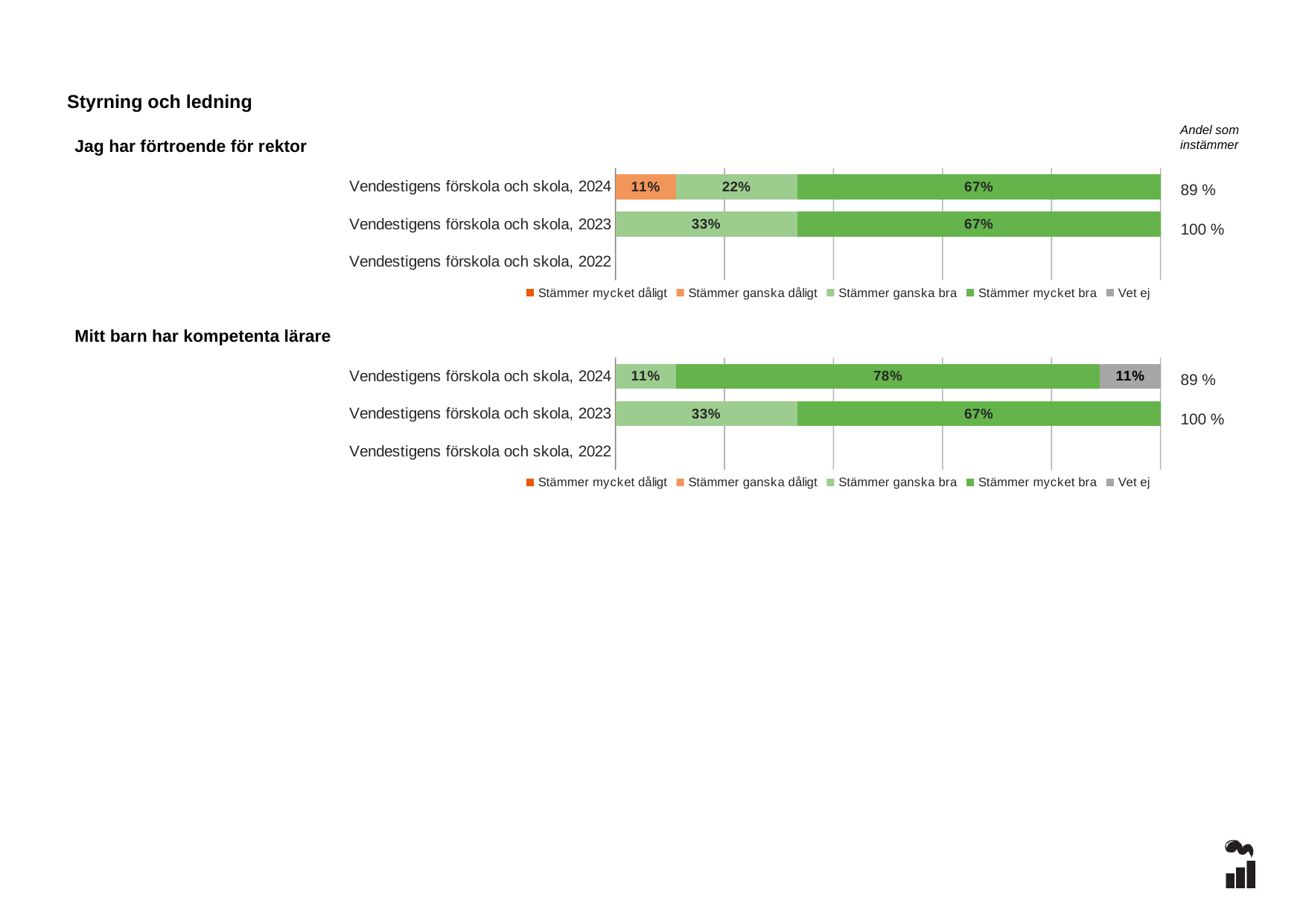
In the chart "Jag har förtroende för rektor", what percentage answered "Stämmer ganska dåligt" for Vendestigens förskola och skola, 2024? 11% In the chart "Mitt barn har kompetenta lärare", what is the "Andel som instämmer" value shown for Vendestigens förskola och skola, 2023? 100 % How many series does the legend of the chart "Jag har förtroende för rektor" list? 5 In the chart "Jag har förtroende för rektor", which is larger for Vendestigens förskola och skola, 2024: the "Stämmer ganska bra" share or the "Stämmer mycket bra" share? Stämmer mycket bra In the chart "Jag har förtroende för rektor", what percentage of respondents answered "Stämmer mycket bra" for Vendestigens förskola och skola, 2024? 67% In the chart "Jag har förtroende för rektor", what percentage answered "Stämmer ganska bra" for Vendestigens förskola och skola, 2023? 33% In the chart "Mitt barn har kompetenta lärare", what percentage answered "Stämmer mycket bra" for Vendestigens förskola och skola, 2024? 78% In the chart "Mitt barn har kompetenta lärare", what percentage answered "Vet ej" for Vendestigens förskola och skola, 2024? 11% In the chart "Jag har förtroende för rektor", what is the "Andel som instämmer" value shown for Vendestigens förskola och skola, 2024? 89 % How many categories (rows) are shown on the y axis of the chart "Mitt barn har kompetenta lärare"? 3 In the chart "Mitt barn har kompetenta lärare", what is the difference between the "Stämmer mycket bra" share for 2024 and for 2023? 11% What kind of chart is "Mitt barn har kompetenta lärare"? Stacked bar chart